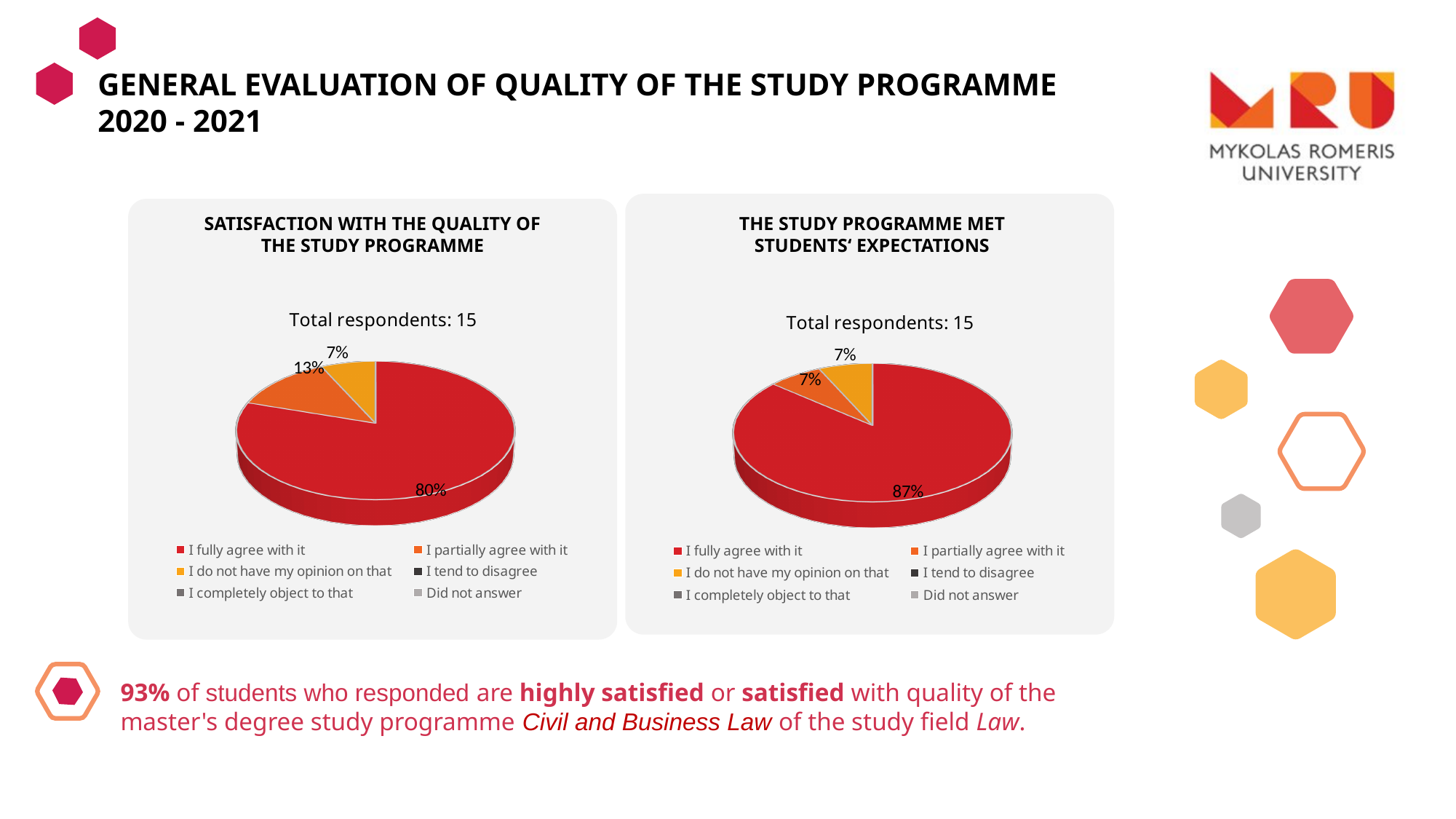
Which chart has the larger share for 'I fully agree with it': 'Satisfaction with the quality of the study programme' or 'The study programme met students' expectations'? The study programme met students' expectations In the 'Satisfaction with the quality of the study programme' chart, which response has the largest slice? I fully agree with it What type of chart is used in 'The study programme met students' expectations'? Pie chart How many entries does the legend of the 'Satisfaction with the quality of the study programme' chart list? 6 In the 'Satisfaction with the quality of the study programme' chart, what share of respondents chose 'I partially agree with it'? 13% In the 'Satisfaction with the quality of the study programme' chart, what share of respondents chose 'I fully agree with it'? 80% In the 'Satisfaction with the quality of the study programme' chart, what is the difference between the 'I fully agree with it' and 'I partially agree with it' shares? 67% In the 'Satisfaction with the quality of the study programme' chart, which response has the smallest labelled slice? I do not have my opinion on that How many labelled slices are shown in the 'The study programme met students' expectations' pie? 3 In the 'The study programme met students' expectations' chart, what share of respondents chose 'I do not have my opinion on that'? 7% How many total respondents are reported for the 'Satisfaction with the quality of the study programme' chart? 15 In the 'The study programme met students' expectations' chart, what share of respondents chose 'I fully agree with it'? 87%